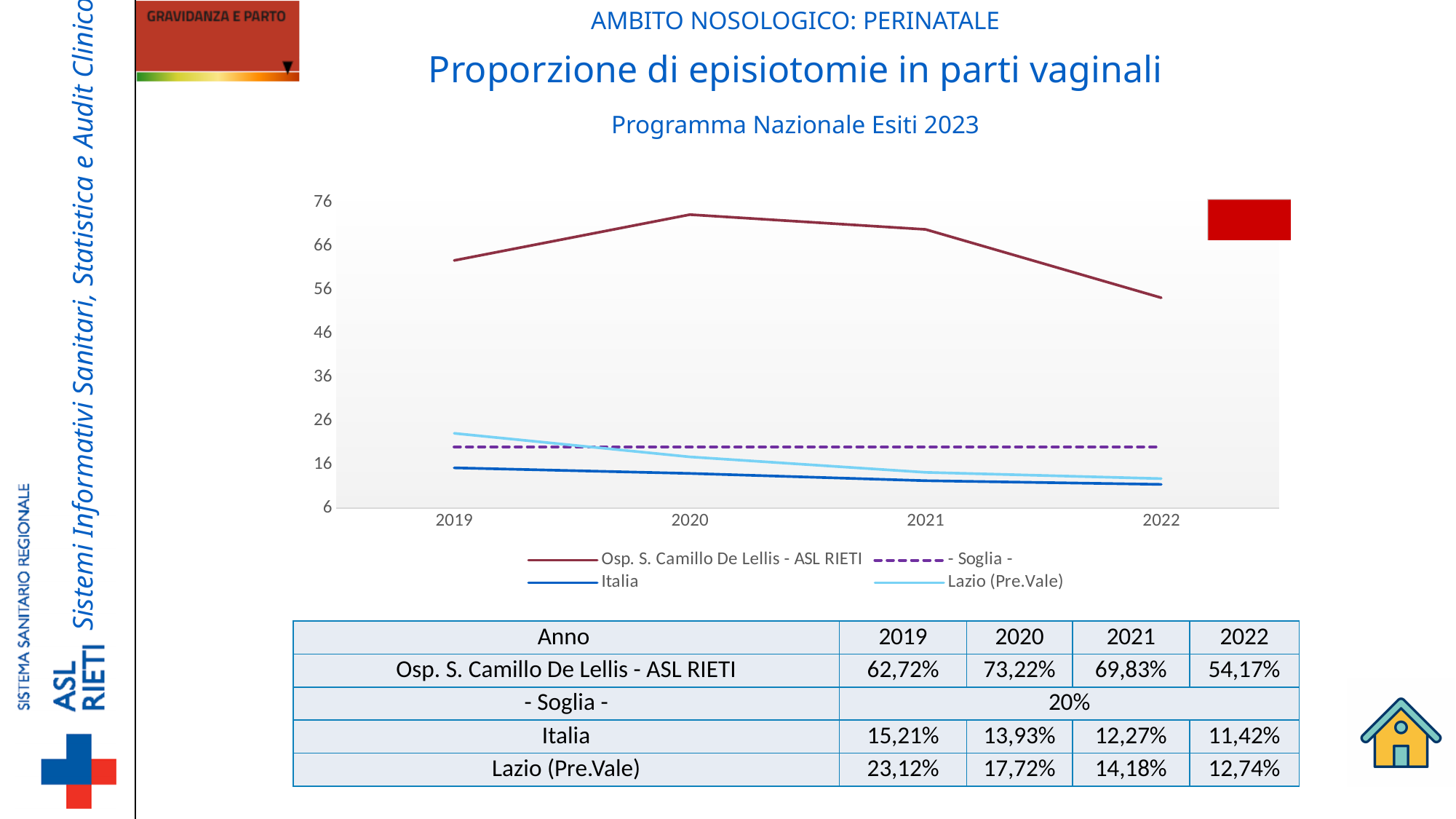
What is the value for Osp. S. Camillo De Lellis - ASL RIETI in 2020? 73,22% In which year is the value for Lazio (Pre.Vale) lowest? 2022 What is the value of the Soglia (threshold) line? 20% Which is larger in 2021, the value for Italia or the value for Lazio (Pre.Vale)? Lazio (Pre.Vale) What is the difference between the Osp. S. Camillo De Lellis - ASL RIETI value in 2020 and in 2022? 19,05% How many years are plotted along the x axis of the chart? 4 What kind of chart is shown on the slide? line chart Does the Italia series rise or fall from 2019 to 2022? fall How many series does the chart legend list? 4 What is the value for Italia in 2022? 11,42% What is the value for Lazio (Pre.Vale) in 2019? 23,12% In which year is the value for Osp. S. Camillo De Lellis - ASL RIETI highest? 2020